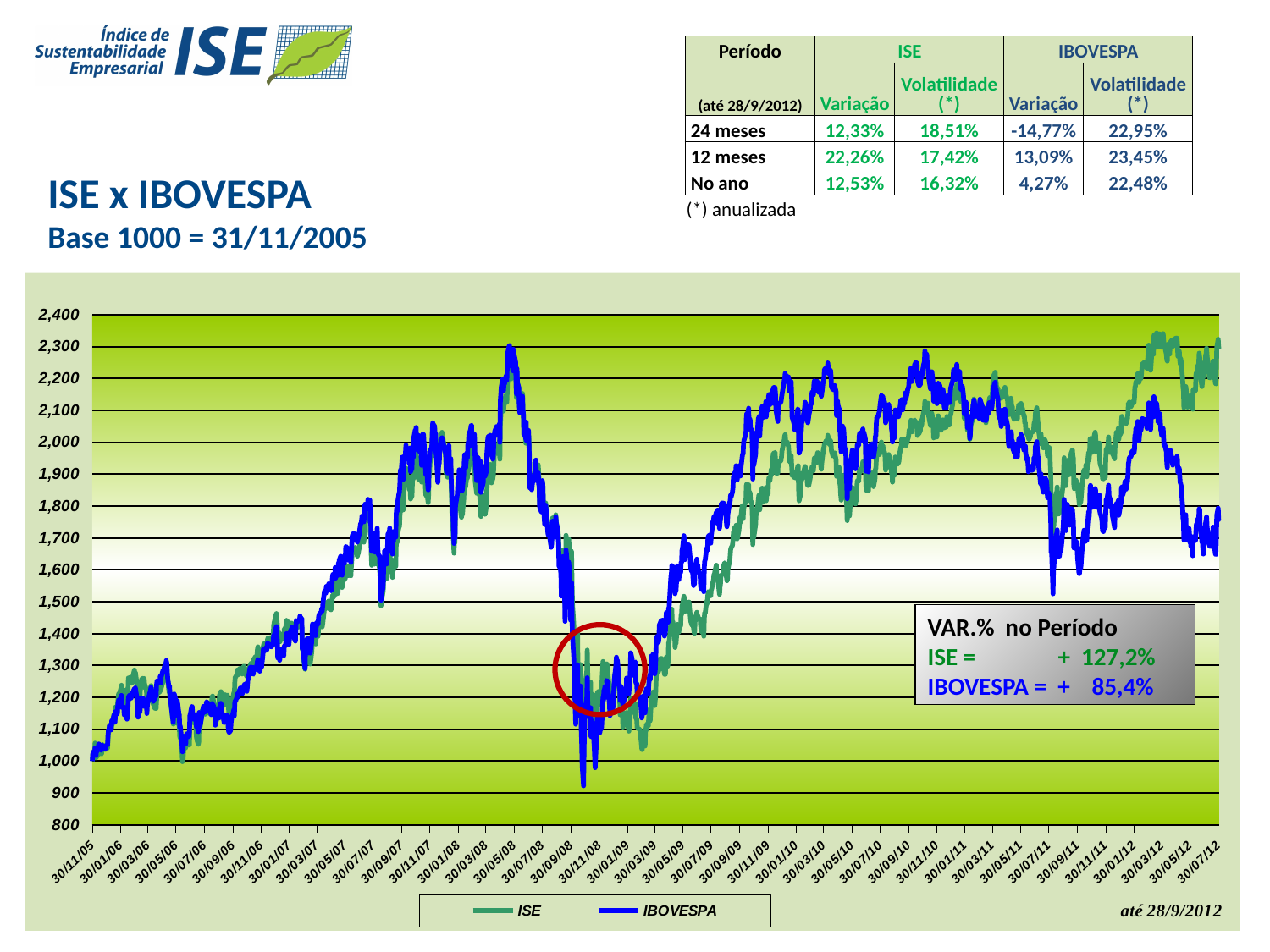
What are the two series named in the chart's legend? ISE and IBOVESPA Which series has the larger VAR.% no Período shown in the annotation box, ISE or IBOVESPA? ISE According to the annotation box on the chart, what is the VAR.% no Período for IBOVESPA? + 85,4% What is the title of the chart? ISE x IBOVESPA According to the annotation box on the chart, what is the VAR.% no Período for ISE? + 127,2% Is the peak of IBOVESPA in mid-2008 greater or less than 2,200? greater Overall, from 30/11/05 to 30/07/12, does the ISE line rise or fall? rise At the end of the chart (30/07/12), which series is higher, ISE or IBOVESPA? ISE Is the lowest point of IBOVESPA in late 2008 greater or less than 1,000? less What kind of chart is shown on the slide? line chart How many series does the chart's legend list? 2